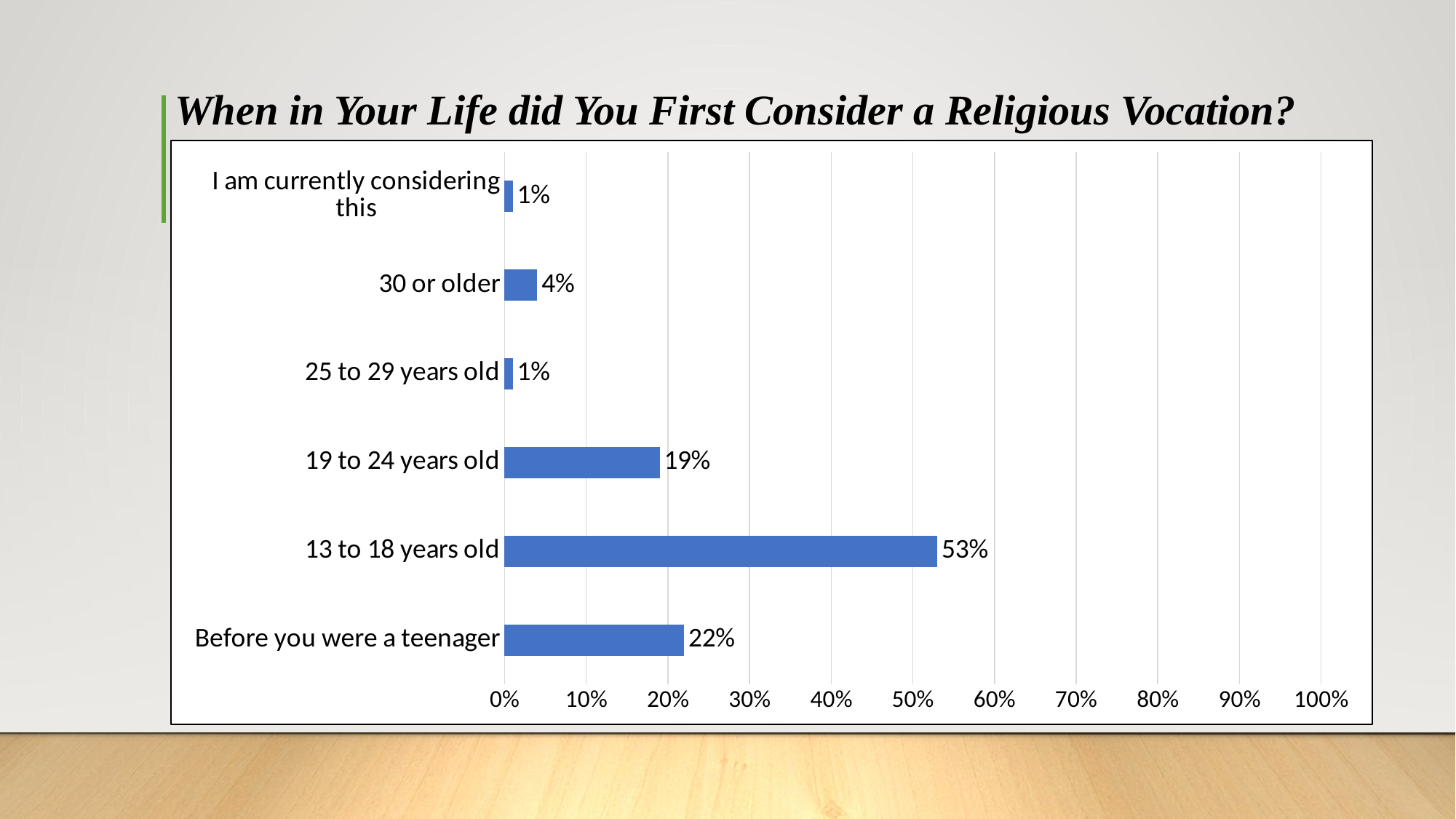
What is the value for '19 to 24 years old'? 19% What kind of chart is shown on the slide? Bar chart Which category has the highest value? 13 to 18 years old What is the value for '30 or older'? 4% What is the title of the chart? When in Your Life did You First Consider a Religious Vocation? What is the difference between the values for '13 to 18 years old' and 'Before you were a teenager'? 31% Which is larger, the value for '30 or older' or the value for '25 to 29 years old'? 30 or older How many categories are shown in the chart? 6 What percentage of respondents first considered a religious vocation at 13 to 18 years old? 53% What is the value for 'Before you were a teenager'? 22% What is the difference between the values for 'Before you were a teenager' and '19 to 24 years old'? 3% Is the value for '13 to 18 years old' greater or less than 50%? greater